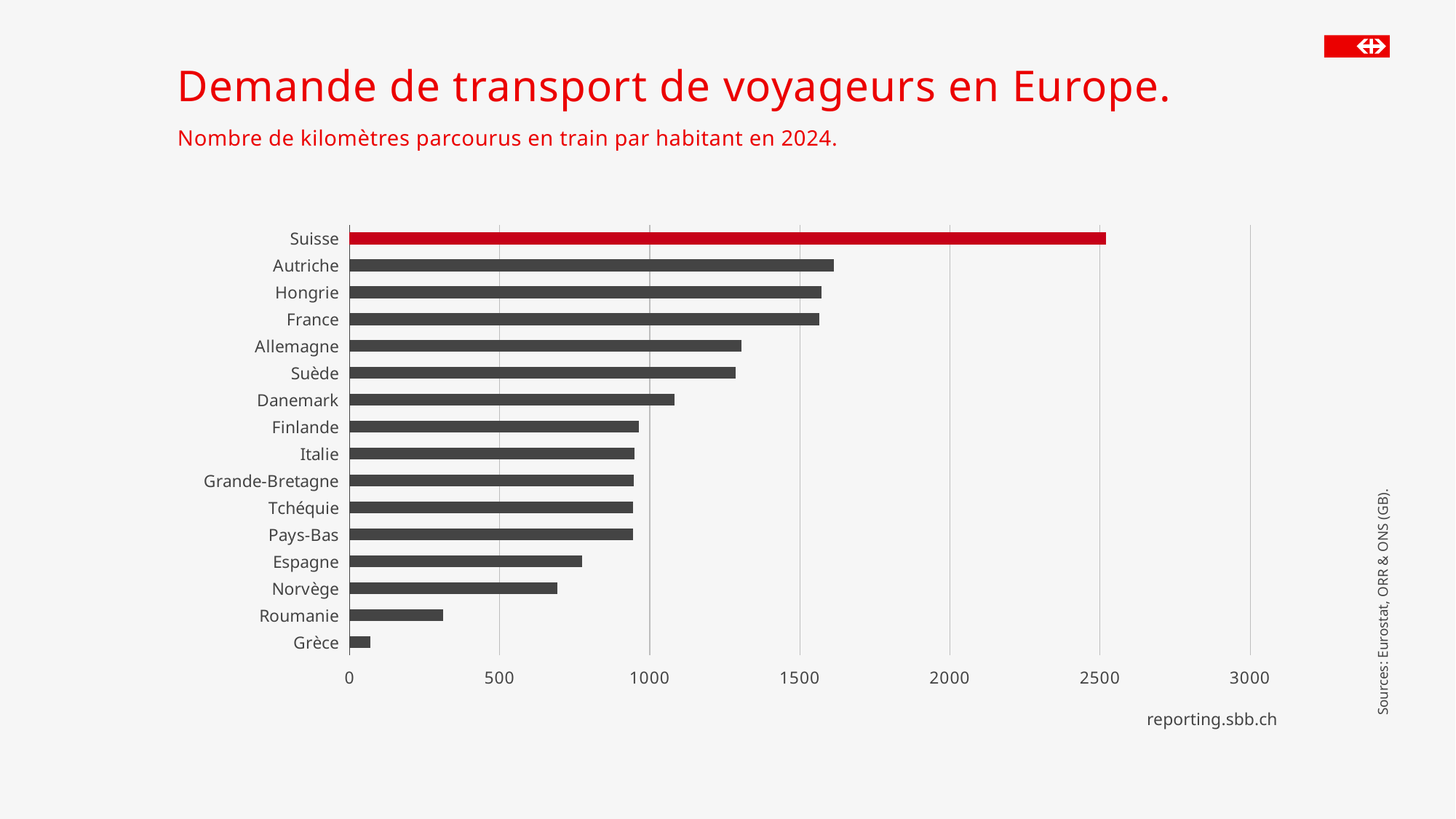
Is the value for Autriche greater or less than 1500? greater Which has a larger value, Espagne or Norvège? Espagne Is the value for Espagne greater or less than 500? greater Which has a larger value, Suisse or Autriche? Suisse What kind of chart is shown on the slide? bar chart Which bar is highlighted in red in the chart? Suisse Is the value for Allemagne greater or less than 1500? less How many countries are shown in the chart? 16 Which country has the highest number of kilometres travelled by train per inhabitant? Suisse Which country has the lowest number of kilometres travelled by train per inhabitant? Grèce